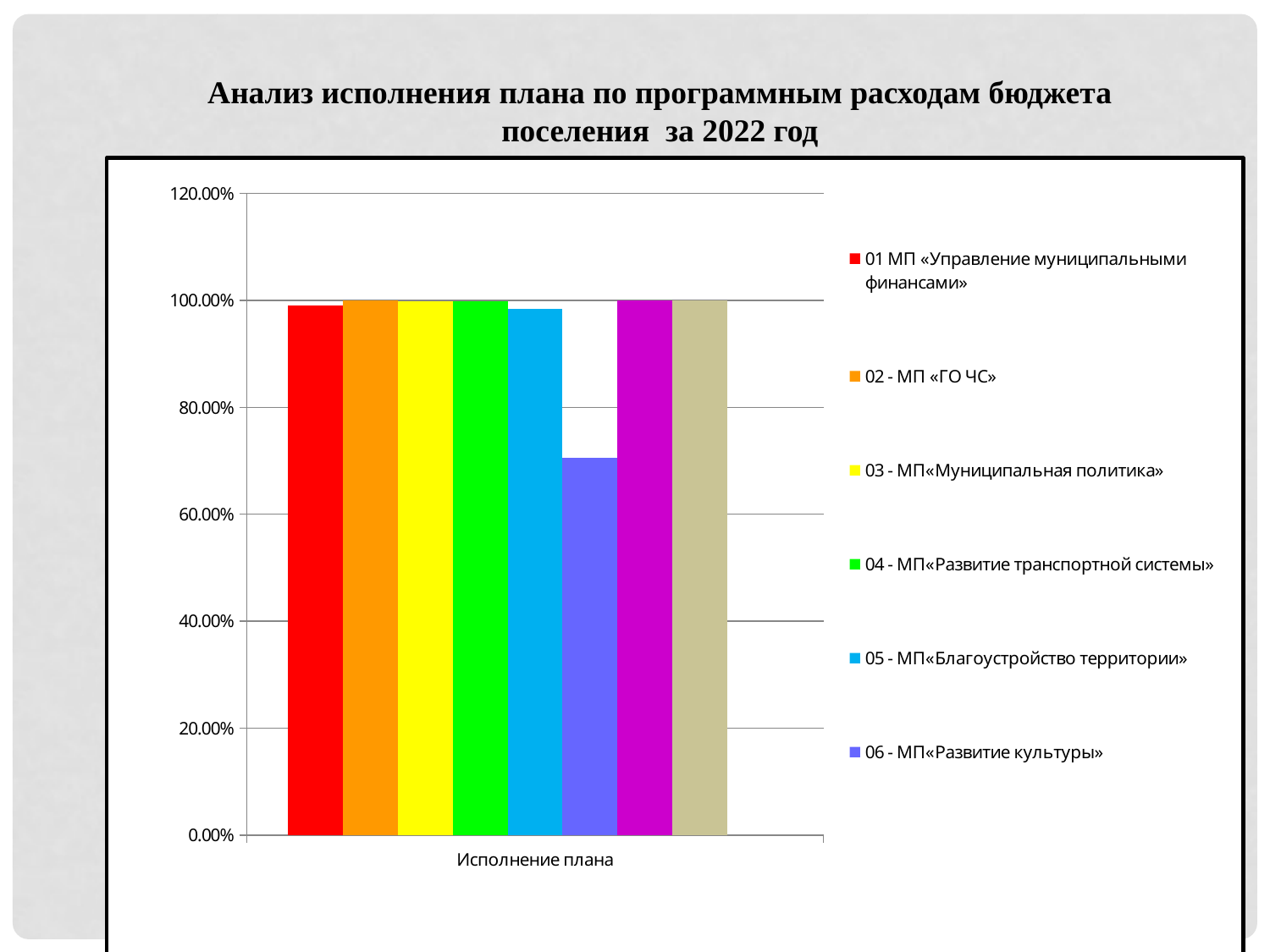
How many series does the legend list? 6 What is the title of the slide above the chart? Анализ исполнения плана по программным расходам бюджета поселения за 2022 год Is the value for 06 - МП«Развитие культуры» greater or less than 60.00%? greater What is the label on the horizontal axis of the chart? Исполнение плана What kind of chart is shown on the slide? bar chart Which is larger, the value for 01 МП «Управление муниципальными финансами» or for 06 - МП«Развитие культуры»? 01 МП «Управление муниципальными финансами» How many bars are plotted in the chart? 8 Which is larger, the value for 05 - МП«Благоустройство территории» or for 06 - МП«Развитие культуры»? 05 - МП«Благоустройство территории» Is the value for 01 МП «Управление муниципальными финансами» greater or less than 80.00%? greater Is the value for 05 - МП«Благоустройство территории» greater or less than 80.00%? greater Which legend series has the lowest value? 06 - МП«Развитие культуры»